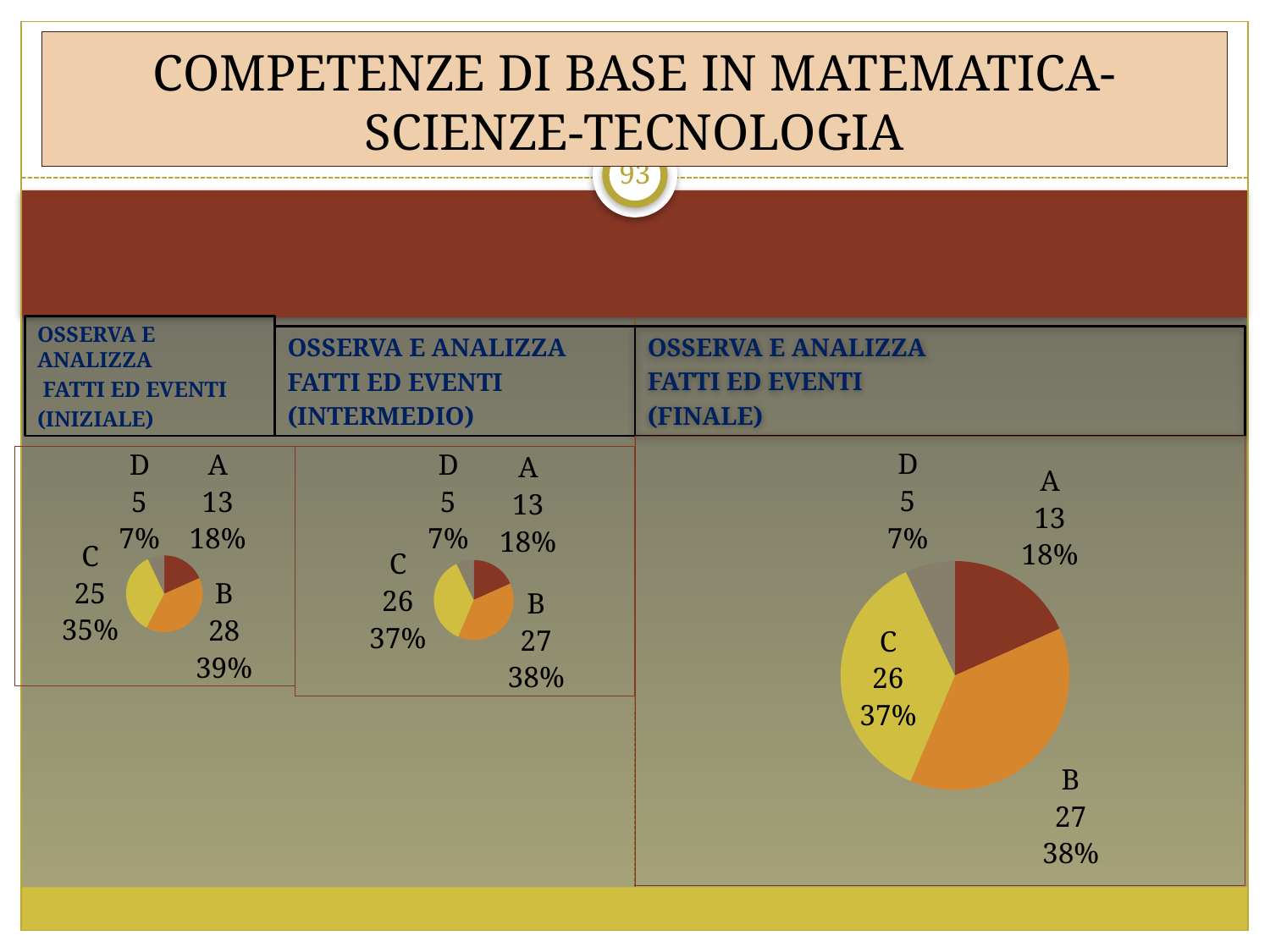
In the left pie chart (INIZIALE), which category has the largest value? B In the left pie chart (INIZIALE), what share of the pie does category C represent? 35% In the middle pie chart (INTERMEDIO), what is the value for category C? 26 In the right pie chart (FINALE), what is the difference between the values for B and A? 14 In the left pie chart (INIZIALE), which category has the smallest value? D In the left pie chart (INIZIALE), what is the difference between the values for B and C? 3 In the right pie chart (FINALE), what is the value for category A? 13 In the left pie chart (INIZIALE), what is the value for category B? 28 How many categories are shown in the right pie chart (FINALE)? 4 In the right pie chart (FINALE), what share of the pie does category D represent? 7% In the middle pie chart (INTERMEDIO), what share of the pie does category B represent? 38% What type of chart is used in the FINALE panel on the right? Pie chart